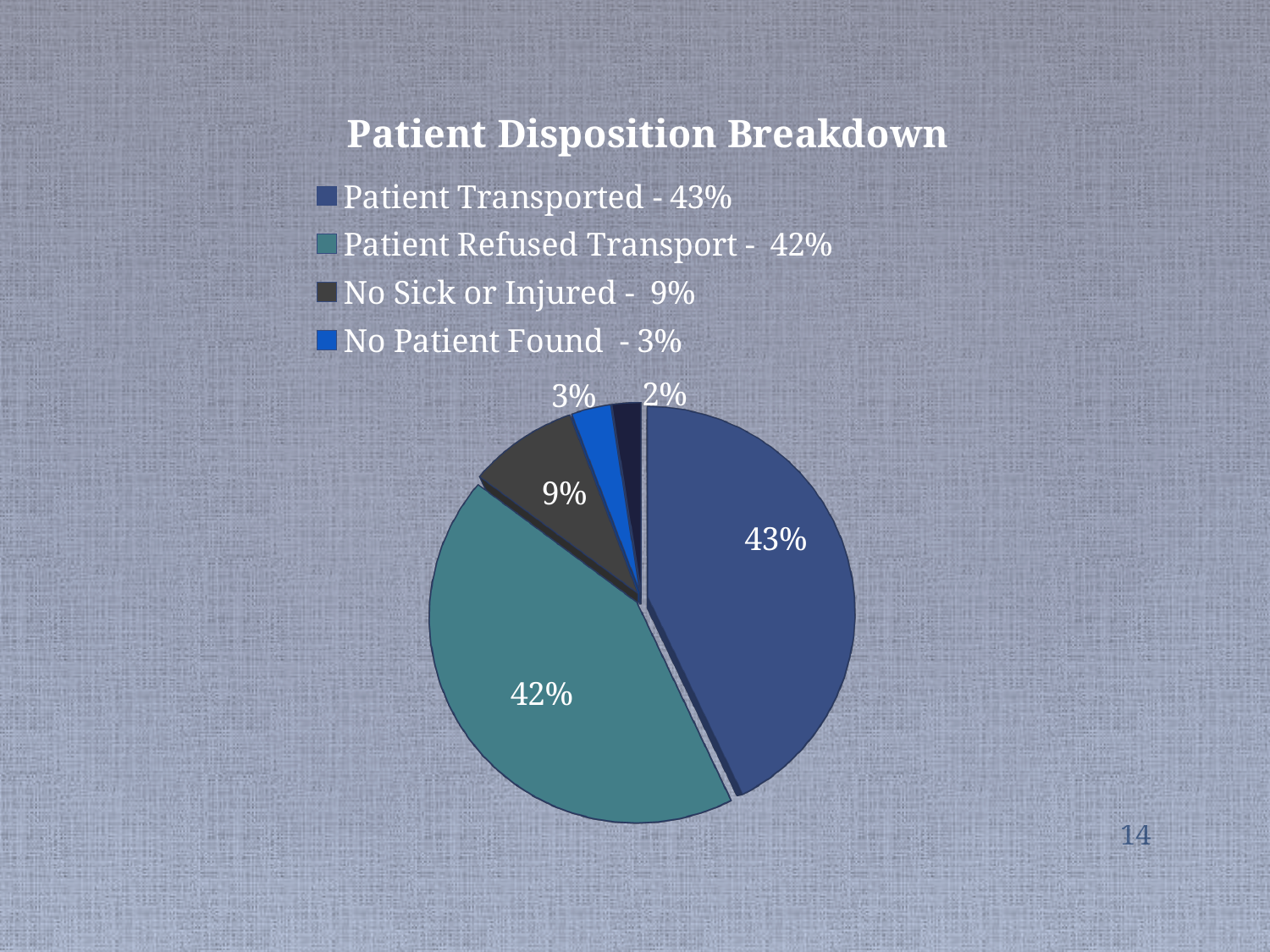
Which of the categories listed in the legend has the smallest share? No Patient Found Which is larger, the share for No Sick or Injured or the share for No Patient Found? No Sick or Injured What is the difference between the Patient Transported share and the Patient Refused Transport share? 1% How many slices does the pie chart have? 5 Which category has the largest share of the pie? Patient Transported What kind of chart is shown on the slide? pie chart What share of the pie is No Sick or Injured? 9% What share of the pie is Patient Transported? 43% What is the title of the chart? Patient Disposition Breakdown What share of the pie is Patient Refused Transport? 42% How many entries does the legend list? 4 What share of the pie is No Patient Found? 3%